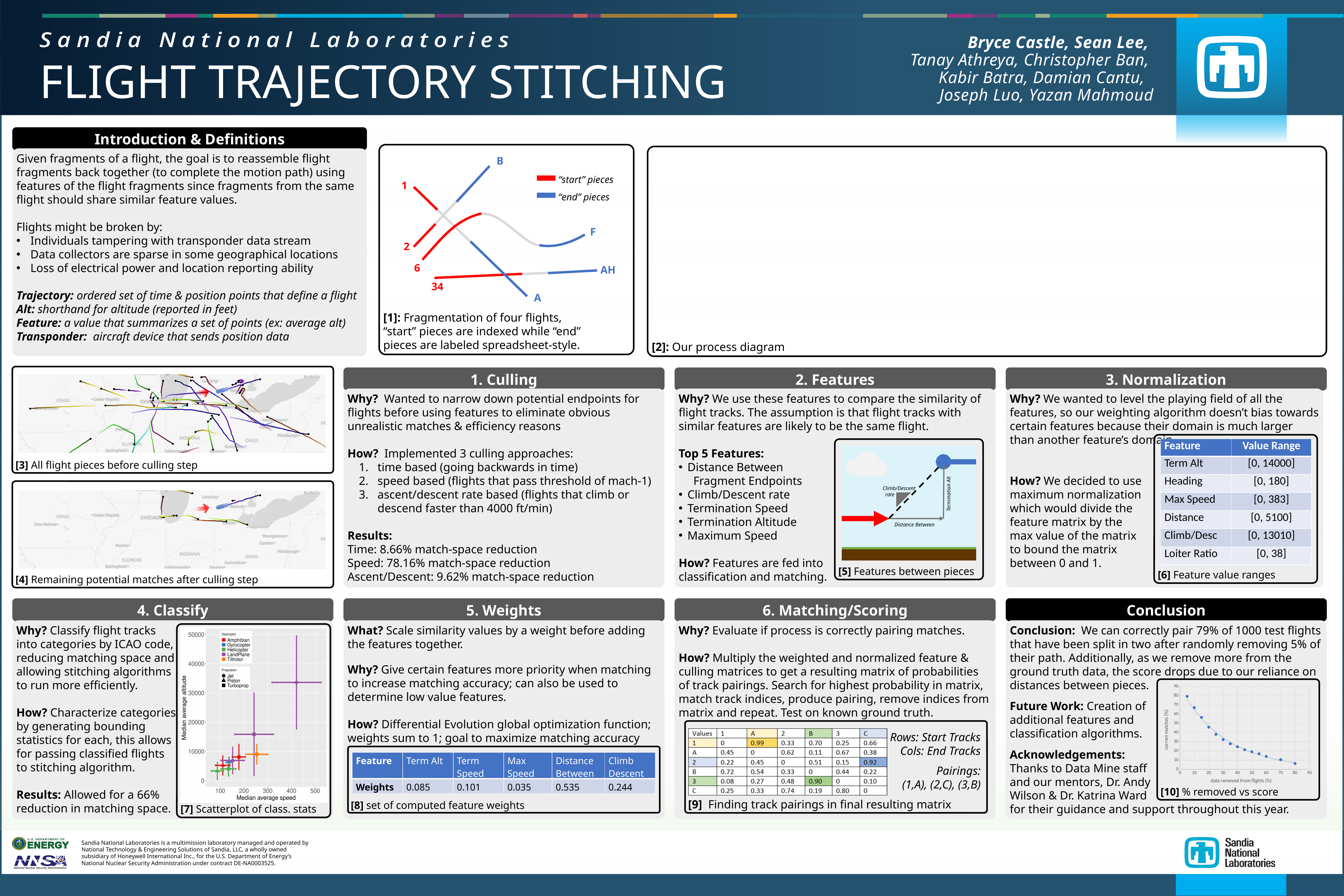
In figure [10] '% removed vs score', is the correct matches value at 80% data removed greater or less than 20? less In figure [7] 'Scatterplot of class. stats', how many Propulsion categories does the legend list? 3 In figure [10] '% removed vs score', is the correct matches value at 10% data removed greater or less than 50? greater In figure [10] '% removed vs score', what is the label of the x axis? data removed from flights (%) In figure [7] 'Scatterplot of class. stats', what colour represents the Helicopter descriptor in the legend? Green What kind of chart is figure [10] '% removed vs score'? Scatter plot In figure [1], how many 'start' pieces are indexed with numbers? 4 In figure [10] '% removed vs score', do the correct-match values rise or fall as the percentage of data removed increases? Fall In figure [7] 'Scatterplot of class. stats', how many Descriptor categories does the legend list? 5 In figure [7] 'Scatterplot of class. stats', which Descriptor category has the point with the highest median average altitude? LandPlane What kind of chart is figure [7] 'Scatterplot of class. stats'? Scatter plot In figure [7] 'Scatterplot of class. stats', is the highest LandPlane point's median average altitude greater or less than 20000? greater